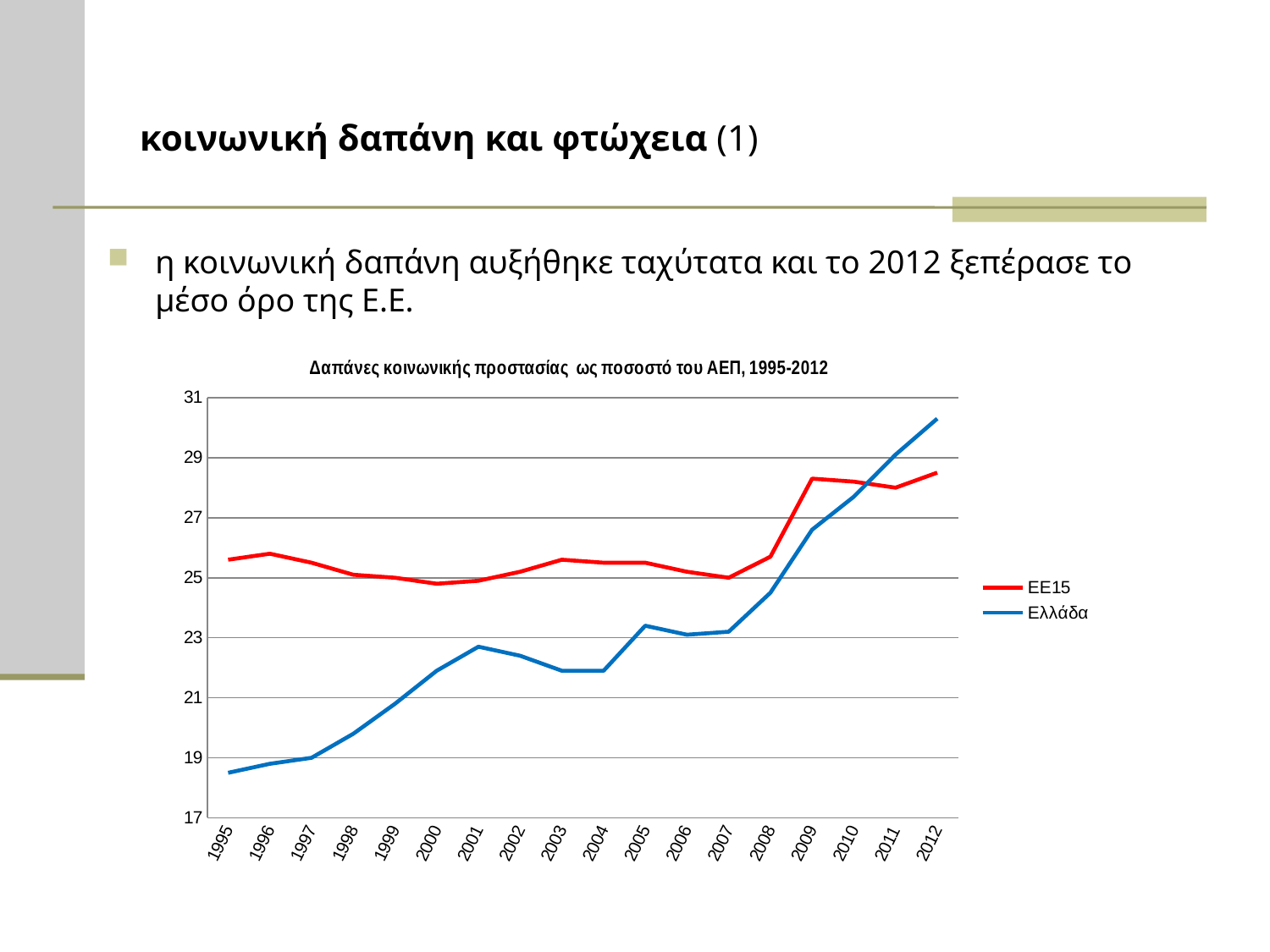
Is the value for EE15 in 2009 greater or less than 27? greater What kind of chart is shown on the slide? line chart How many series does the legend list? 2 Is the value for Ελλάδα in 2004 greater or less than 23? less How many years are plotted along the x axis? 18 In 1995, which series has the larger value, EE15 or Ελλάδα? EE15 In which year is the Ελλάδα value highest? 2012 Is the value for Ελλάδα in 2012 greater or less than 29? greater In 2012, which series has the larger value, EE15 or Ελλάδα? Ελλάδα In which year is the Ελλάδα value lowest? 1995 Does the Ελλάδα line generally rise or fall from 1995 to 2012? rise